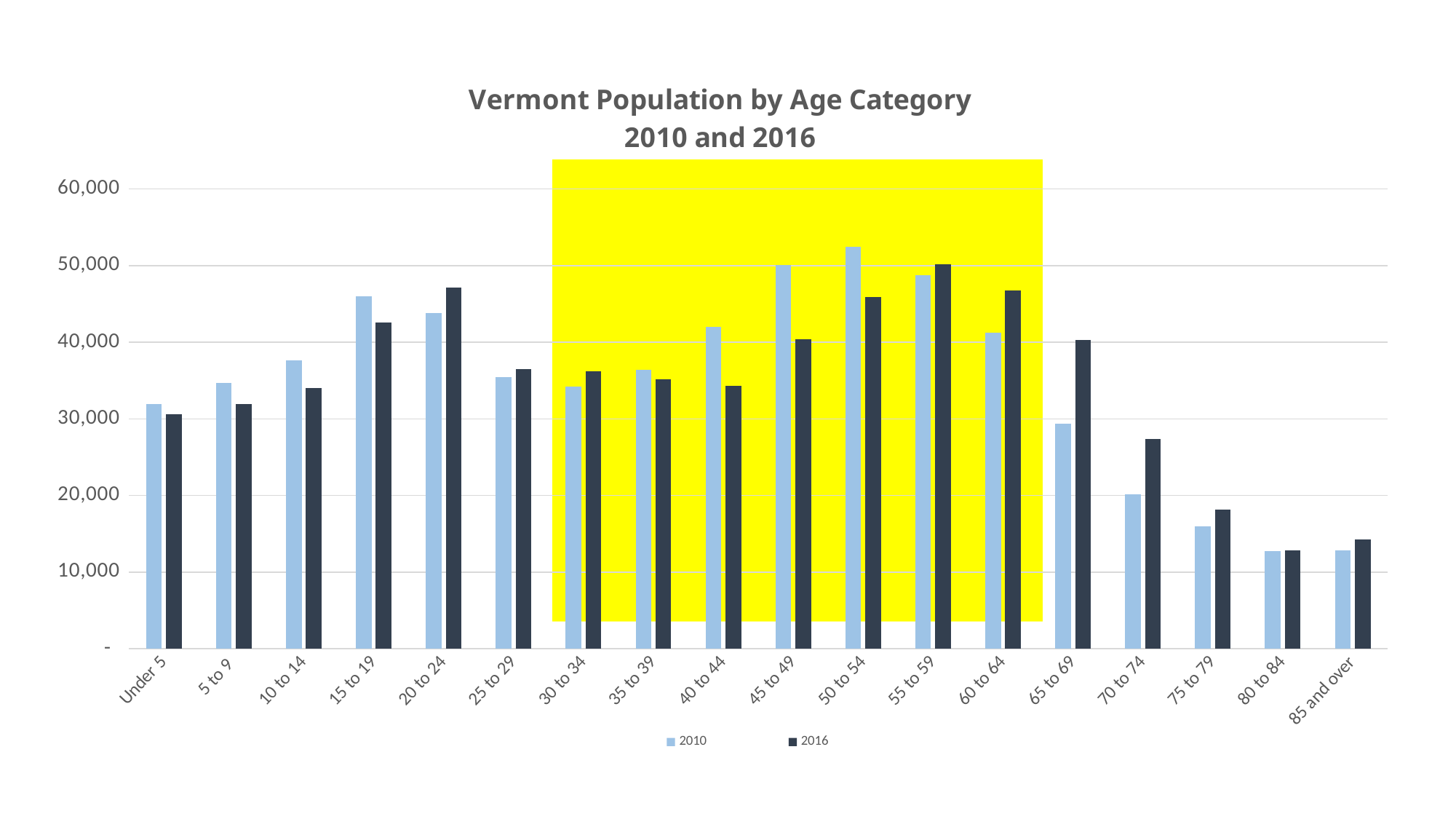
Is the 2010 value for 15 to 19 greater or less than 40,000? greater Do the 2016 values rise or fall from 65 to 69 through 80 to 84? fall Is the 2010 value for 50 to 54 greater or less than 50,000? greater Which age category has the highest 2010 value? 50 to 54 How many age categories are shown on the x axis? 18 For the 65 to 69 category, which is larger, the 2010 value or the 2016 value? 2016 For the 15 to 19 category, which is larger, the 2010 value or the 2016 value? 2010 Is the 2016 value for 70 to 74 greater or less than 30,000? less How many series does the legend list? 2 Which age category has the highest 2016 value? 55 to 59 Which age category has the lowest 2016 value? 80 to 84 What kind of chart is shown on the slide? bar chart